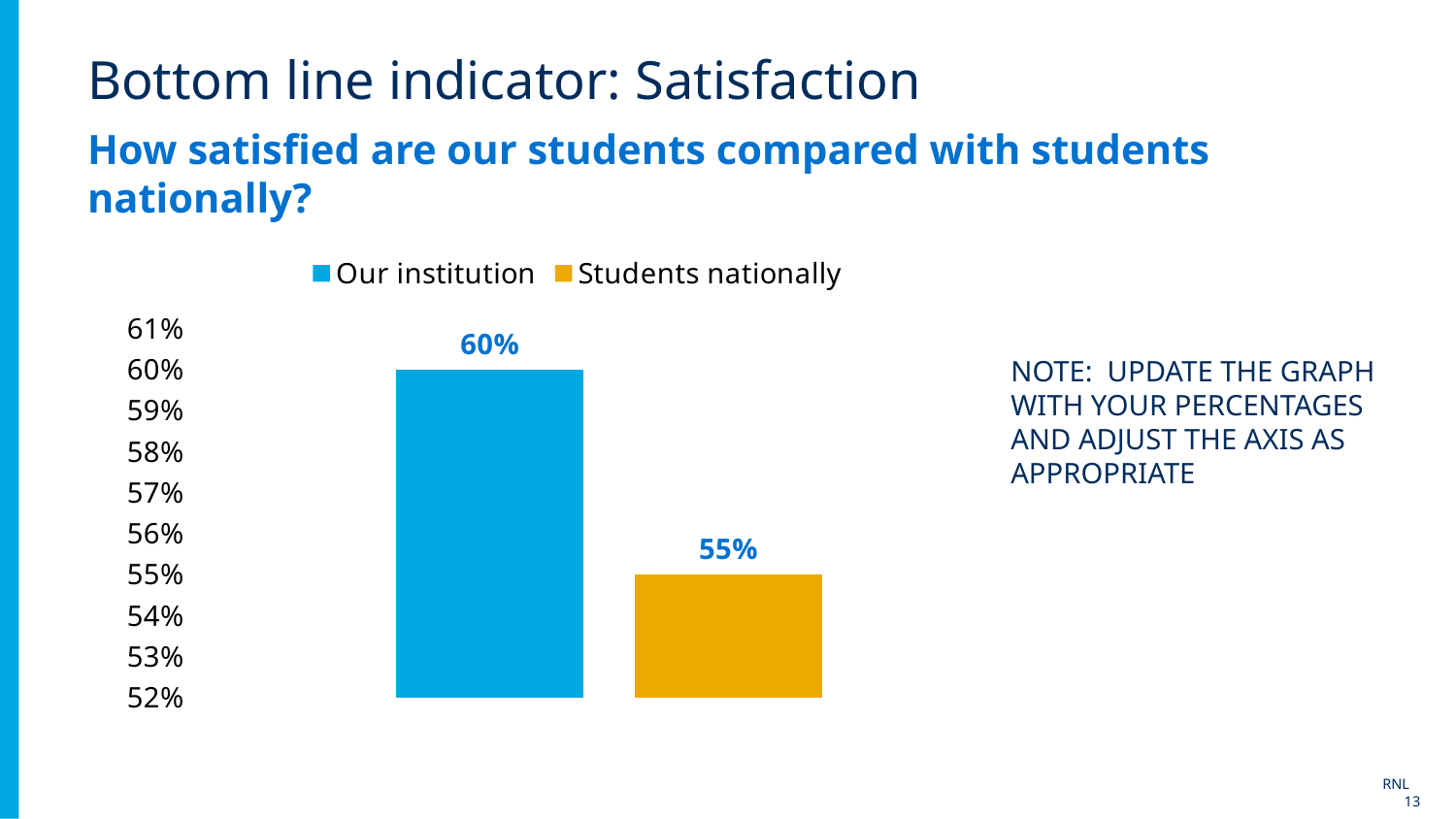
What colour is the bar for Students nationally? Orange/yellow Is the value for Our institution greater or less than 58%? greater Is the value for Students nationally greater or less than 57%? less What is the satisfaction value for Our institution? 60% What is the difference between the Our institution value and the Students nationally value? 5% What is the satisfaction value for Students nationally? 55% What kind of chart is shown on the slide? Bar chart How many bars are plotted on the chart? 2 How many series does the legend list? 2 Which series has the higher value, Our institution or Students nationally? Our institution What is the lowest value shown on the vertical axis? 52% Which series has the lowest value on the chart? Students nationally